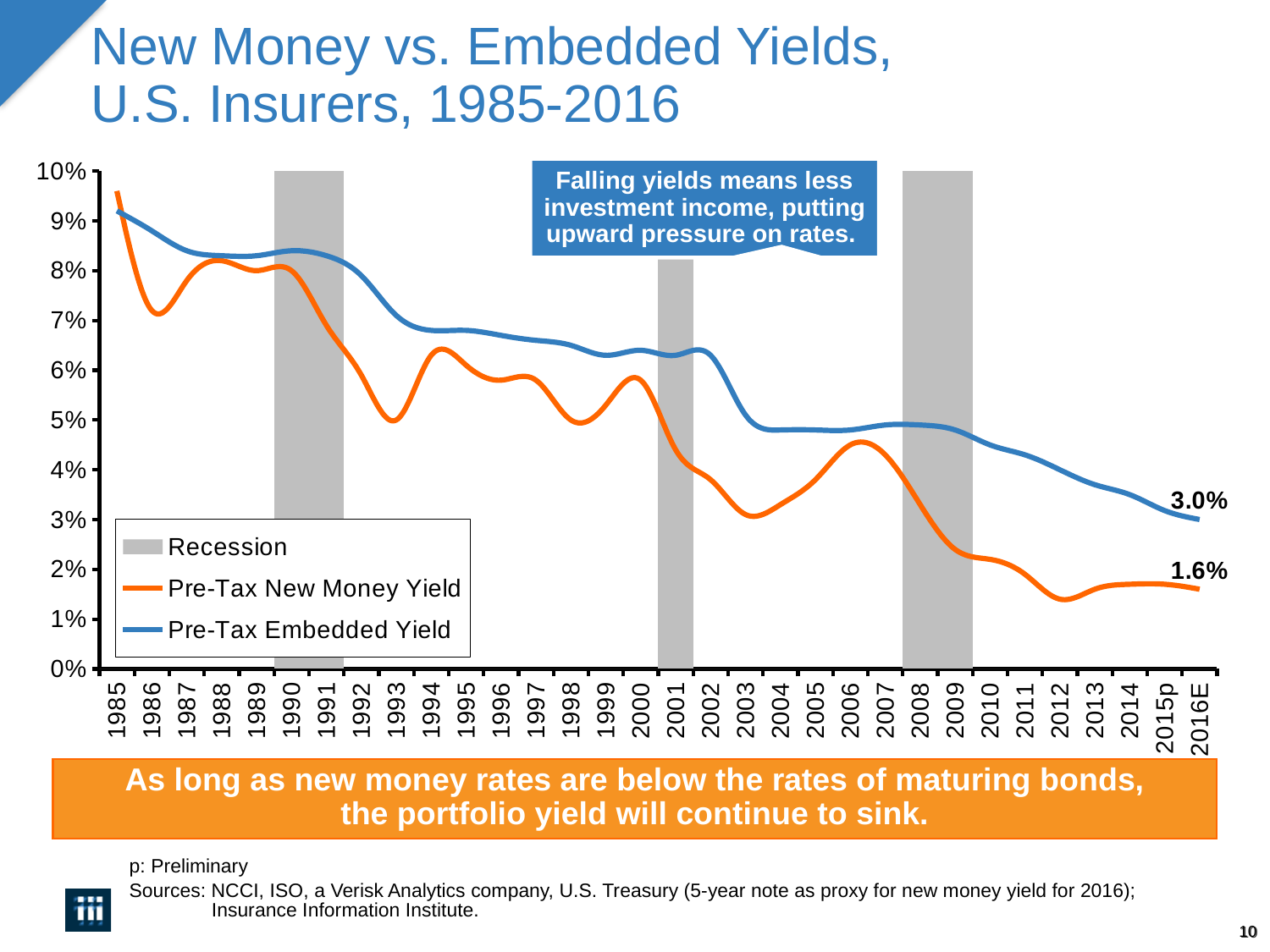
What colour is the Pre-Tax New Money Yield line? Orange In which year is the Pre-Tax New Money Yield at its highest? 1985 What is the difference between the Pre-Tax Embedded Yield and the Pre-Tax New Money Yield in 2016E? 1.4 percentage points What kind of chart is shown on the slide? Line chart Is the Pre-Tax Embedded Yield in 1985 greater or less than 8%? greater Is the Pre-Tax New Money Yield in 1993 greater or less than 6%? less What is the Pre-Tax Embedded Yield for 2016E? 3.0% What is the Pre-Tax New Money Yield for 2016E? 1.6% How many entries does the chart's legend list? 3 In 2012, which is higher: the Pre-Tax New Money Yield or the Pre-Tax Embedded Yield? Pre-Tax Embedded Yield How many years are labeled on the x axis of the chart? 32 Does the Pre-Tax Embedded Yield rise or fall from 1985 to 2016E? Fall